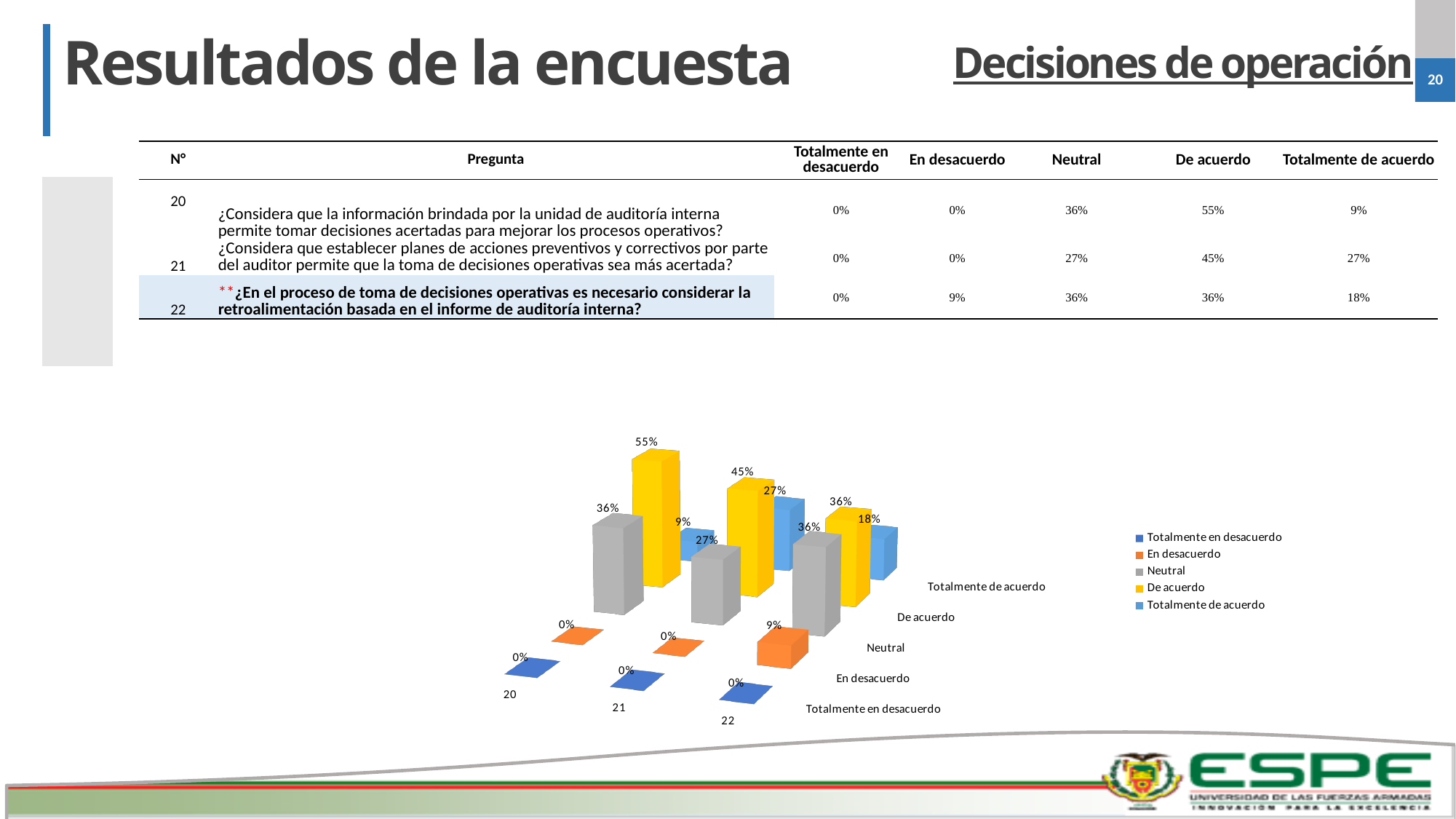
Which question has the lowest value for 'Totalmente de acuerdo'? 20 What is the value for 'Totalmente de acuerdo' for question 22? 18% How many series does the chart legend list? 5 Which question has the highest value for 'De acuerdo'? 20 Which question has the larger 'Totalmente de acuerdo' value, 20 or 21? 21 What is the value for 'Neutral' for question 21? 27% What is the difference between the 'De acuerdo' values for question 20 and question 21? 10% Do the 'De acuerdo' values rise or fall from question 20 to question 22? Fall What is the value for 'En desacuerdo' for question 22? 9% How many questions are shown on the x axis of the chart? 3 What is the value for 'De acuerdo' for question 20? 55% What kind of chart is shown on the slide? Bar chart